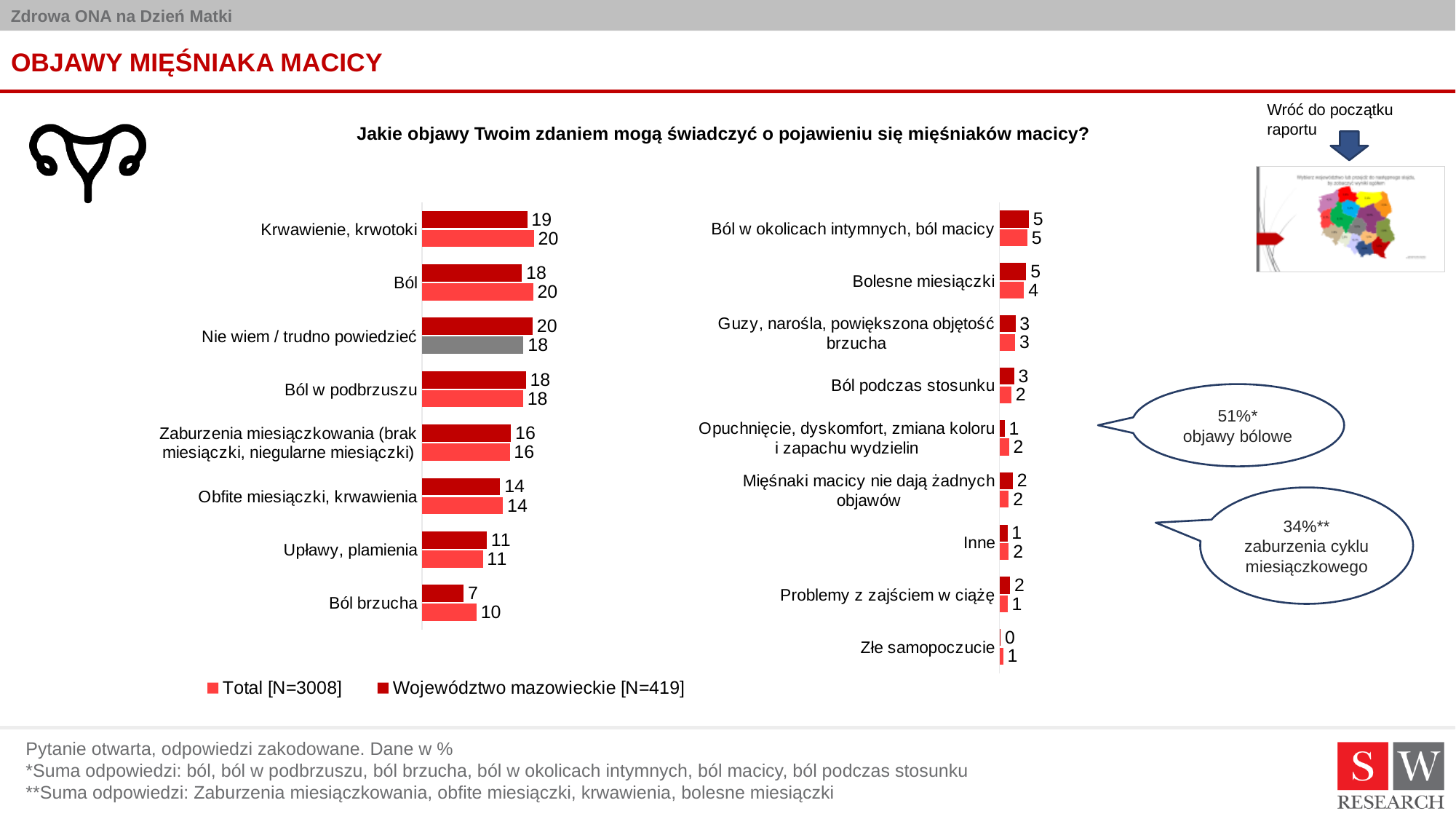
How many series does the legend list? 2 In the left chart, which category has the lowest Total [N=3008] value? Ból brzucha How many categories are shown in the right chart? 9 In the left chart, which category has the highest Województwo mazowieckie [N=419] value? Nie wiem / trudno powiedzieć In the left chart, for Ból, which is larger: the Total value or the Województwo mazowieckie value? Total In the right chart, what is the Województwo mazowieckie [N=419] value for Złe samopoczucie? 0 In the left chart, what is the Województwo mazowieckie [N=419] value for Ból brzucha? 7 How many categories are shown in the left chart? 8 In the left chart, what is the Total [N=3008] value for Krwawienie, krwotoki? 20 In the right chart, what is the Total [N=3008] value for Bolesne miesiączki? 4 In the left chart, what is the difference between the Total and Województwo mazowieckie values for Ból brzucha? 3 What type of chart is used on this slide? Bar chart